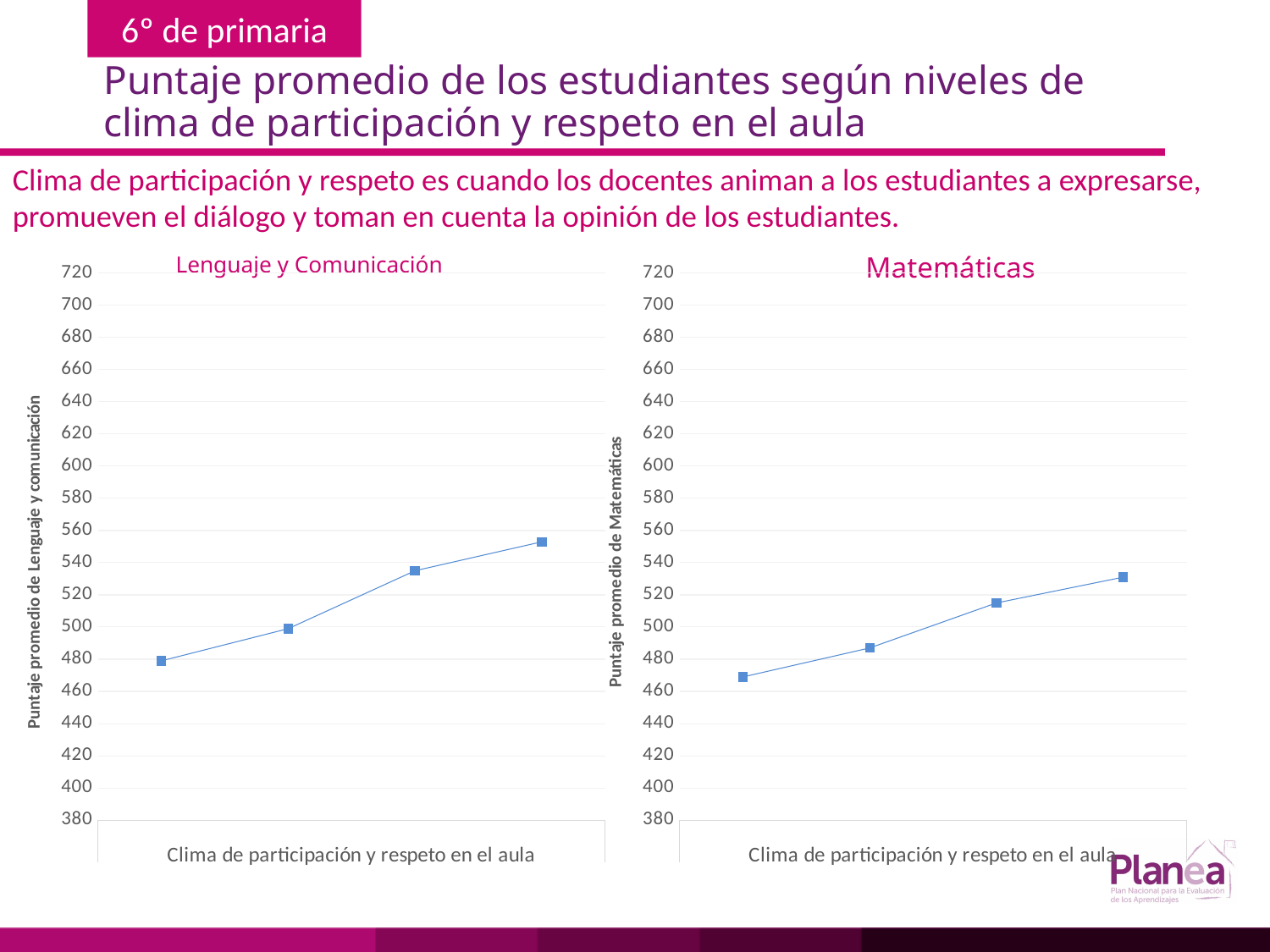
Which is larger, the last point of the Lenguaje y Comunicación chart or the last point of the Matemáticas chart? Lenguaje y Comunicación What kind of chart is the Lenguaje y Comunicación chart? line chart What is the title of the chart on the right? Matemáticas What is the x-axis label of the Lenguaje y Comunicación chart? Clima de participación y respeto en el aula In the Lenguaje y Comunicación chart, is the value of the last (rightmost) point greater or less than 540? greater Which point is highest in the Matemáticas chart, the first or the last? the last In the Matemáticas chart, is the value of the last (rightmost) point greater or less than 520? greater In the Matemáticas chart, is the value of the first (leftmost) point greater or less than 480? less In the Matemáticas chart, do the values rise or fall from left to right along the x axis? rise How many data points are plotted in the Matemáticas chart? 4 In the Lenguaje y Comunicación chart, do the values rise or fall from left to right along the x axis? rise